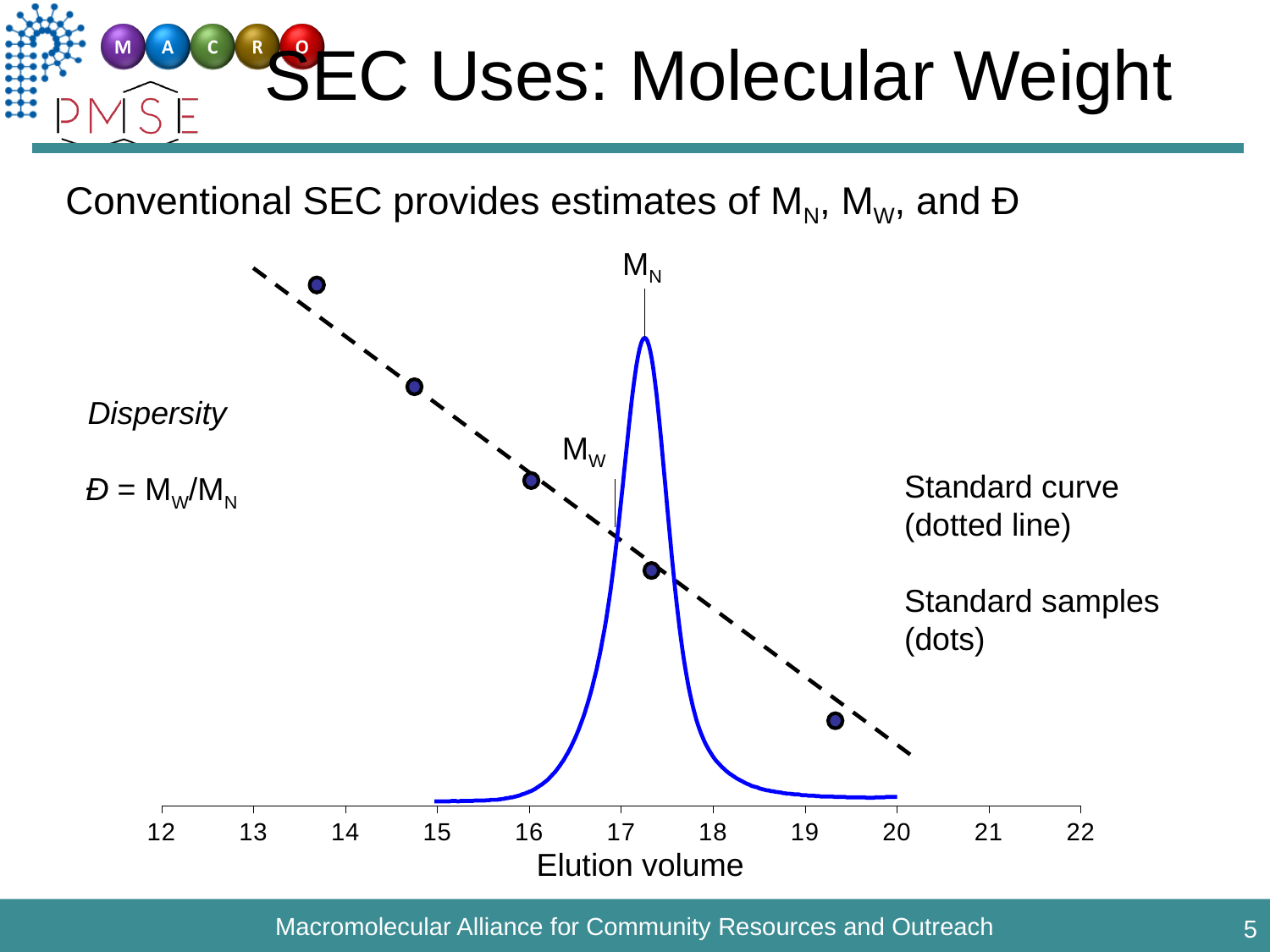
Does the dashed standard curve rise or fall as elution volume increases? fall How many standard sample dots are plotted on the chart? 5 Is the elution volume at the peak of the blue curve greater or less than 16? greater Which standard sample dot sits highest on the chart, the leftmost or the rightmost? leftmost Is the elution volume of the leftmost standard sample dot greater or less than 13? greater Which marked quantity, M_N or M_W, is located at the larger elution volume on the chart? M_N What is the lowest value shown on the x axis of the chart? 12 Is the elution volume at the peak of the blue curve greater or less than 18? less What is the label on the x axis of the chart? Elution volume What is the highest value shown on the x axis of the chart? 22 According to the slide, what does the dotted line on the chart represent? Standard curve